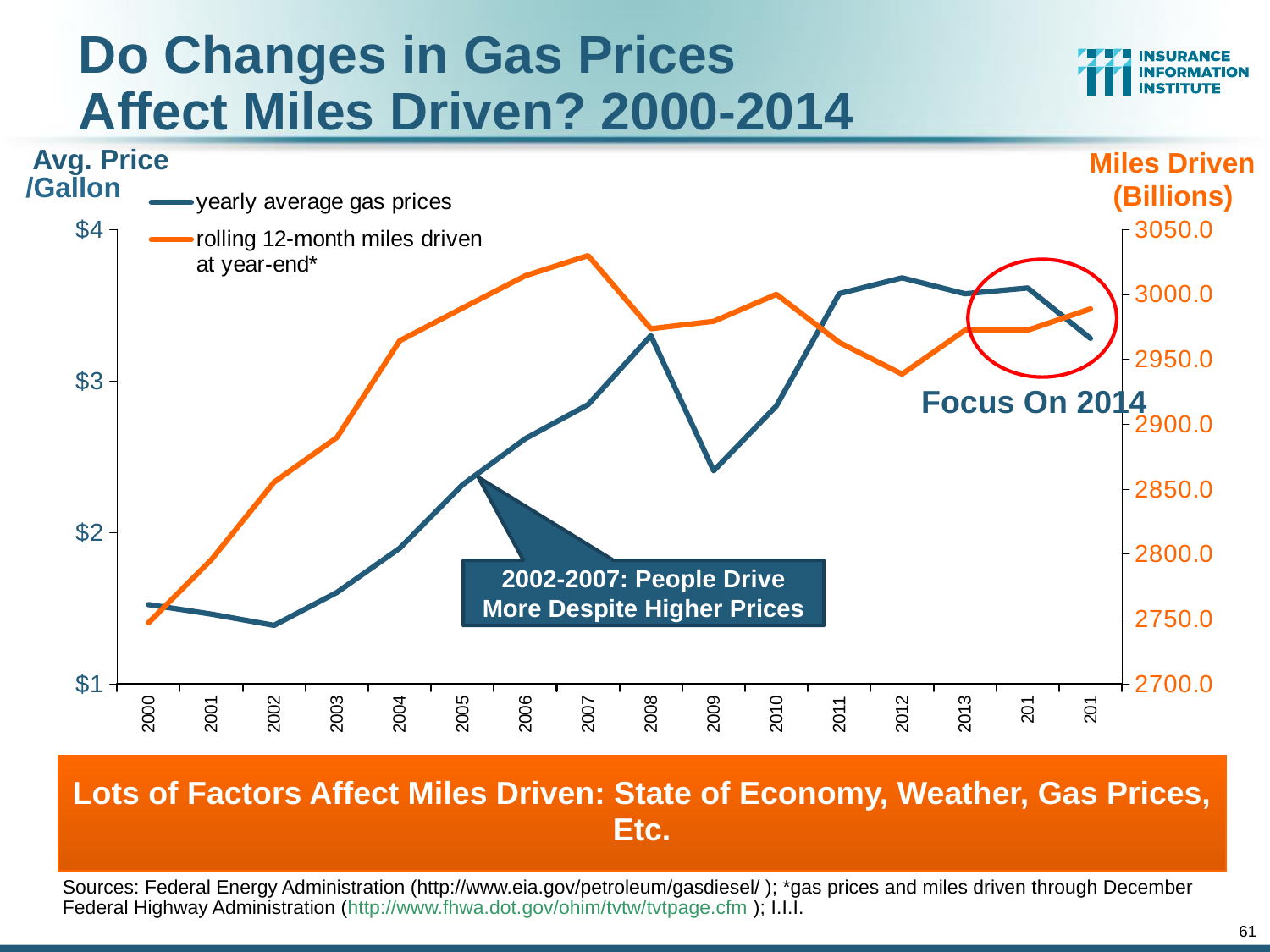
In which year is the rolling 12-month miles driven highest? 2007 What is the label of the left vertical axis? Avg. Price /Gallon Which series is plotted in orange? rolling 12-month miles driven at year-end* What kind of chart is shown on the slide? line chart How many series does the legend list? 2 Which year has the higher yearly average gas price, 2008 or 2009? 2008 Is the rolling 12-month miles driven in 2007 greater or less than 3000.0 billion? greater In which year is the rolling 12-month miles driven lowest? 2000 In which year is the yearly average gas price lowest? 2002 Do the rolling 12-month miles driven rise or fall from 2000 to 2007? rise Is the yearly average gas price in 2009 greater or less than $3? less Is the yearly average gas price in 2008 greater or less than $3? greater